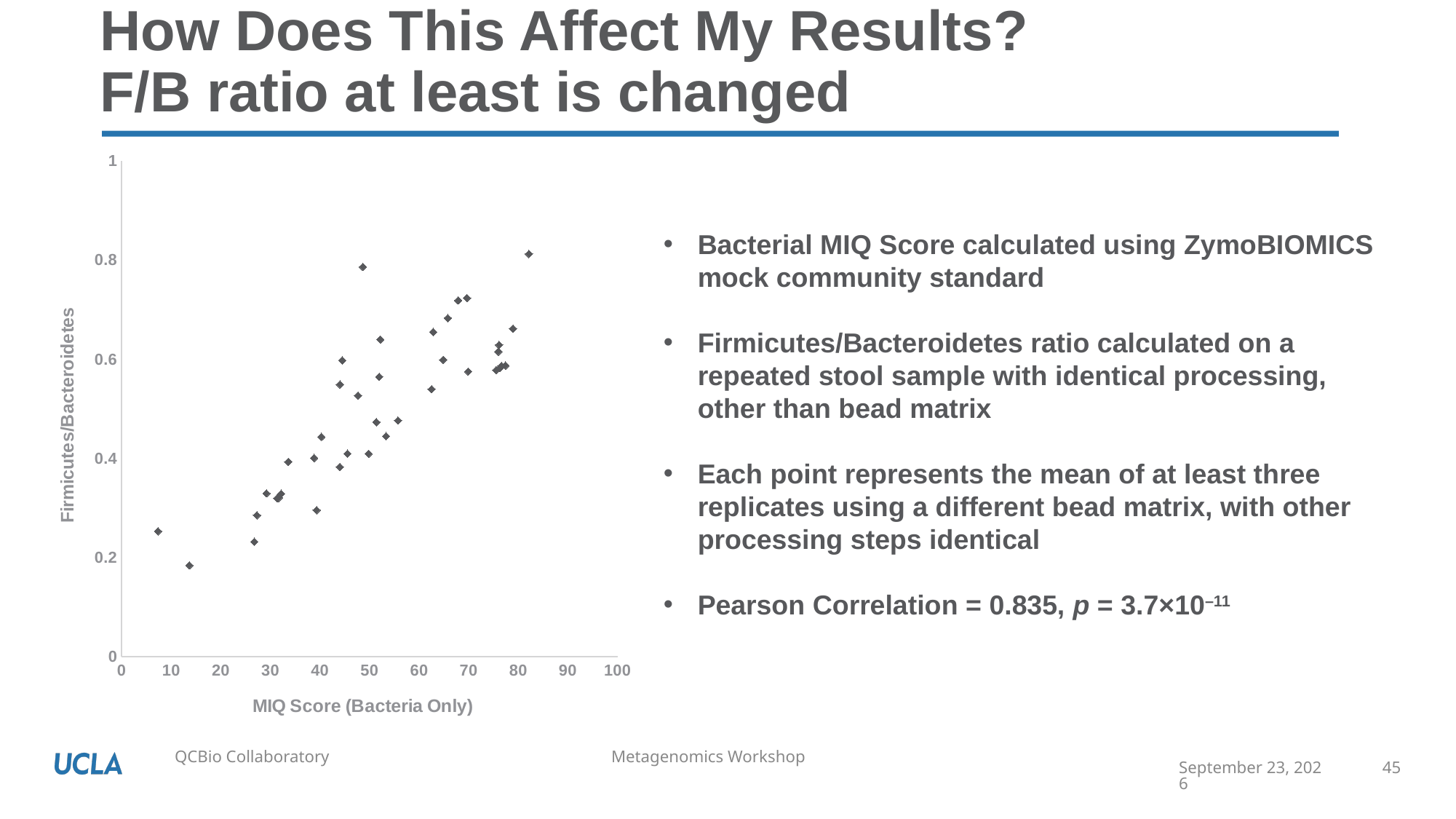
Is the lowest Firmicutes/Bacteroidetes value plotted greater or less than 0.4? less As the MIQ Score increases along the x axis, do the Firmicutes/Bacteroidetes values generally rise or fall? rise Is the highest Firmicutes/Bacteroidetes value plotted greater or less than 0.6? greater What kind of chart is shown on the slide? scatter plot Is the highest MIQ Score plotted greater or less than 70? greater What is the maximum value shown on the x axis of the chart? 100 What is the label of the x axis of the chart? MIQ Score (Bacteria Only) What is the label of the y axis of the chart? Firmicutes/Bacteroidetes